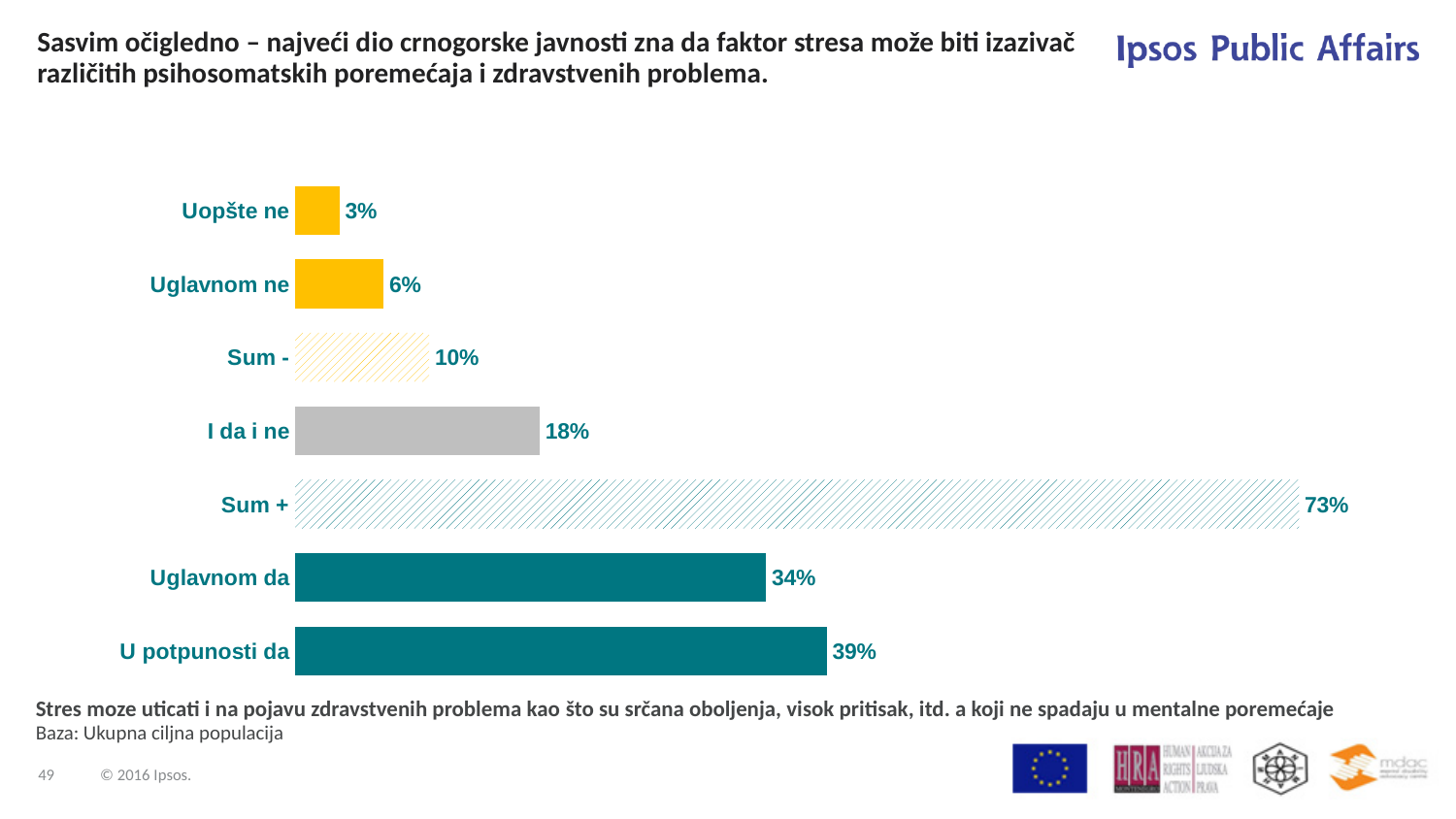
What is the value for "I da i ne"? 18% Which category has the lowest value? Uopšte ne What kind of chart is shown on the slide? Bar chart What is the value for "Sum +"? 73% What is the difference between "Sum +" and "Sum -"? 63% Which category has the highest value? Sum + Which is larger, "I da i ne" or "Sum -"? I da i ne What is the value for "Uglavnom ne"? 6% What is the value for "U potpunosti da"? 39% What is the difference between "U potpunosti da" and "Uglavnom da"? 5% Which two categories are drawn with hatched (striped) bars? Sum - and Sum + How many categories are shown in the chart? 7